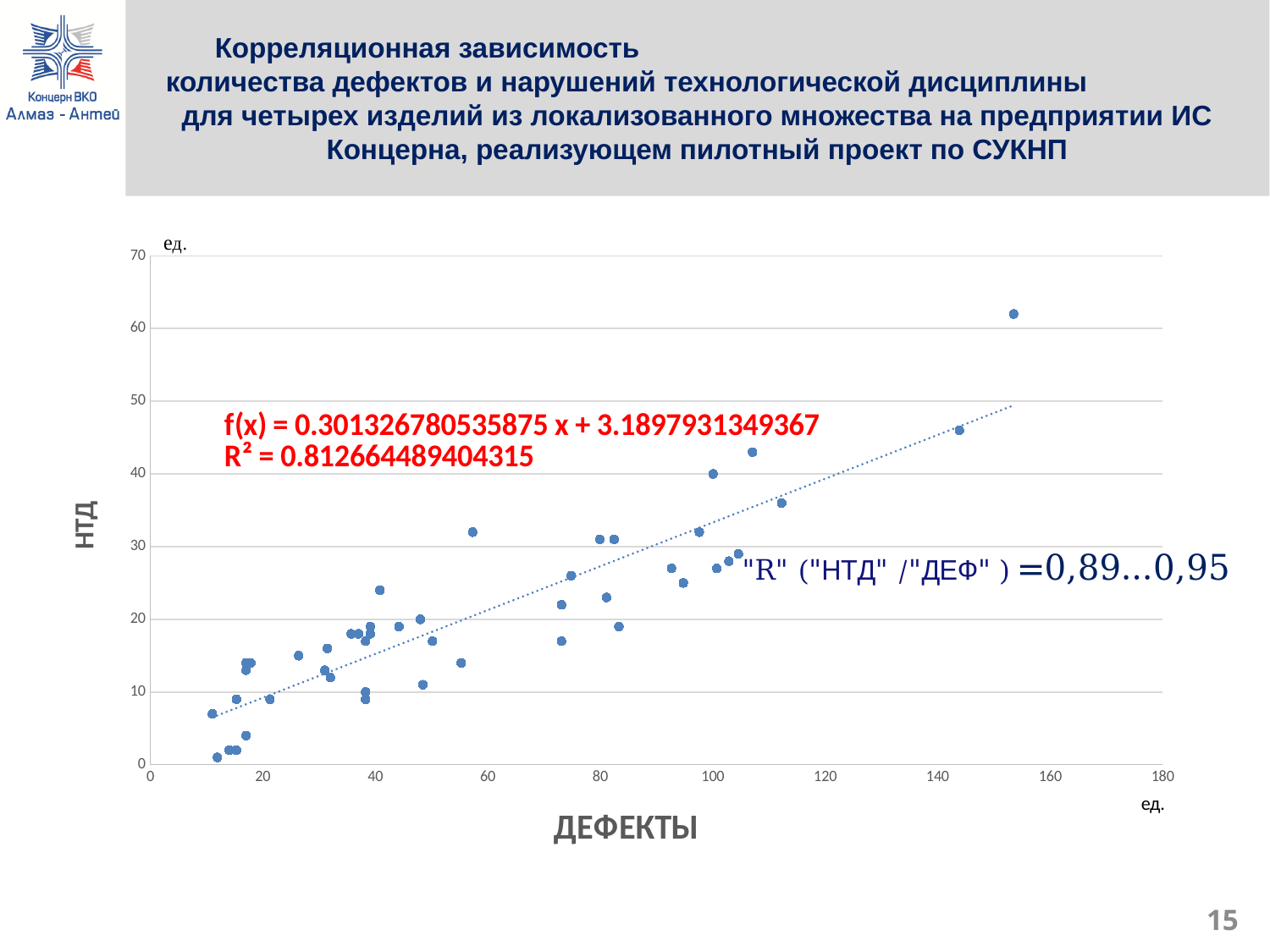
What R² value is printed on the chart? 0.812664489404315 What is the title of the horizontal axis of the chart? ДЕФЕКТЫ What is the maximum value shown on the vertical axis? 70 Is the НТД value of the leftmost point on the chart greater or less than 10? less What is the maximum value shown on the horizontal axis? 180 What kind of chart is shown on the slide? scatter chart What is the title of the vertical axis of the chart? НТД Is the ДЕФЕКТЫ value of the highest point on the chart greater or less than 140? greater What range of the correlation coefficient R is stated on the chart? 0,89...0,95 What trendline equation is printed on the chart? f(x) = 0.301326780535875 x + 3.1897931349367 Do the НТД values generally rise or fall as the number of ДЕФЕКТЫ increases? rise Is the НТД value of the highest point on the chart greater or less than 60? greater